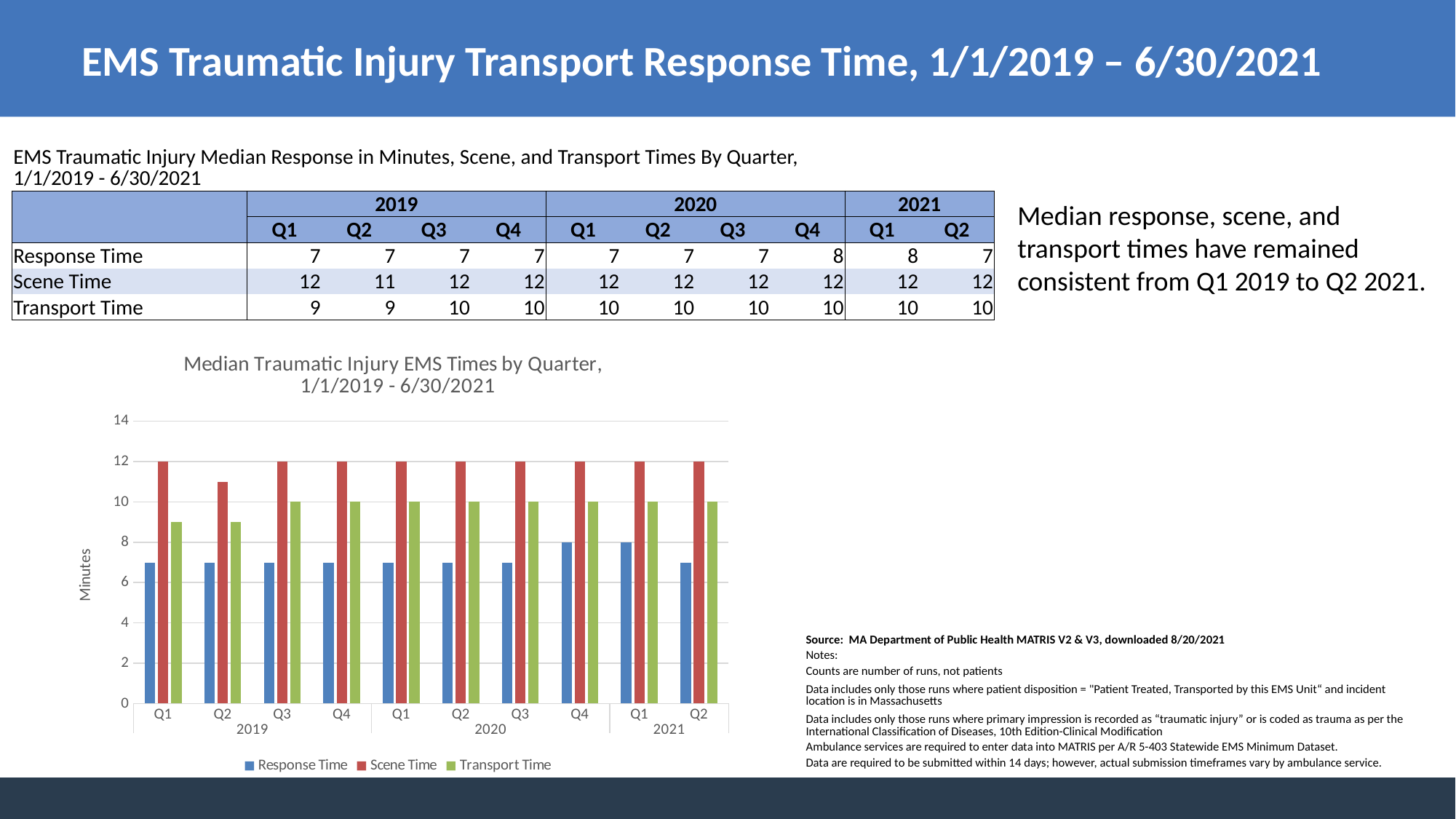
How many quarters are plotted along the x axis of the chart? 10 What is the difference between Scene Time and Response Time in Q1 2020? 5 What is the median Response Time for Q4 2020? 8 What is the median Transport Time for Q1 2019? 9 How many series does the chart legend list? 3 What is the label on the y axis of the chart? Minutes What is the median Scene Time for Q2 2019? 11 Is the Scene Time for Q3 2020 greater or less than 10? greater Which colour represents Scene Time in the chart? red In which quarter is the Scene Time lowest? Q2 2019 What type of chart is shown on the slide? bar chart Which is larger in Q2 2021, Transport Time or Response Time? Transport Time